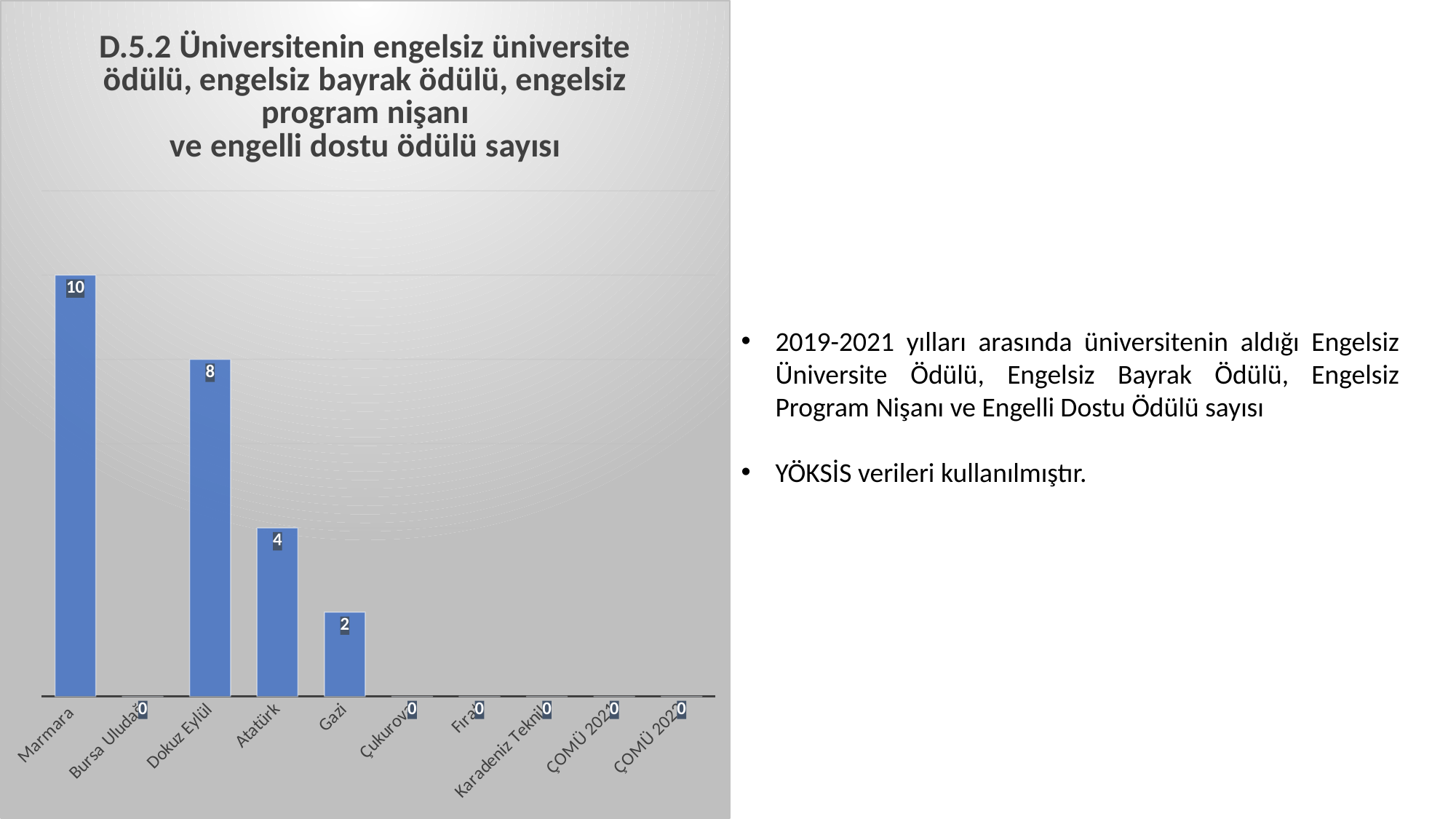
What is the difference between the values for Marmara and Dokuz Eylül? 2 How many categories are shown on the x axis? 10 What is the value for Dokuz Eylül? 8 What is the difference between the values for Atatürk and Gazi? 2 What kind of chart is shown on the slide? Bar chart Which is larger, the value for Dokuz Eylül or the value for Atatürk? Dokuz Eylül How many categories have a value of 0? 6 Which university has the highest value? Marmara What is the value for Gazi? 2 What is the value for ÇOMÜ 2021? 0 What is the value for Marmara? 10 What is the value for Atatürk? 4